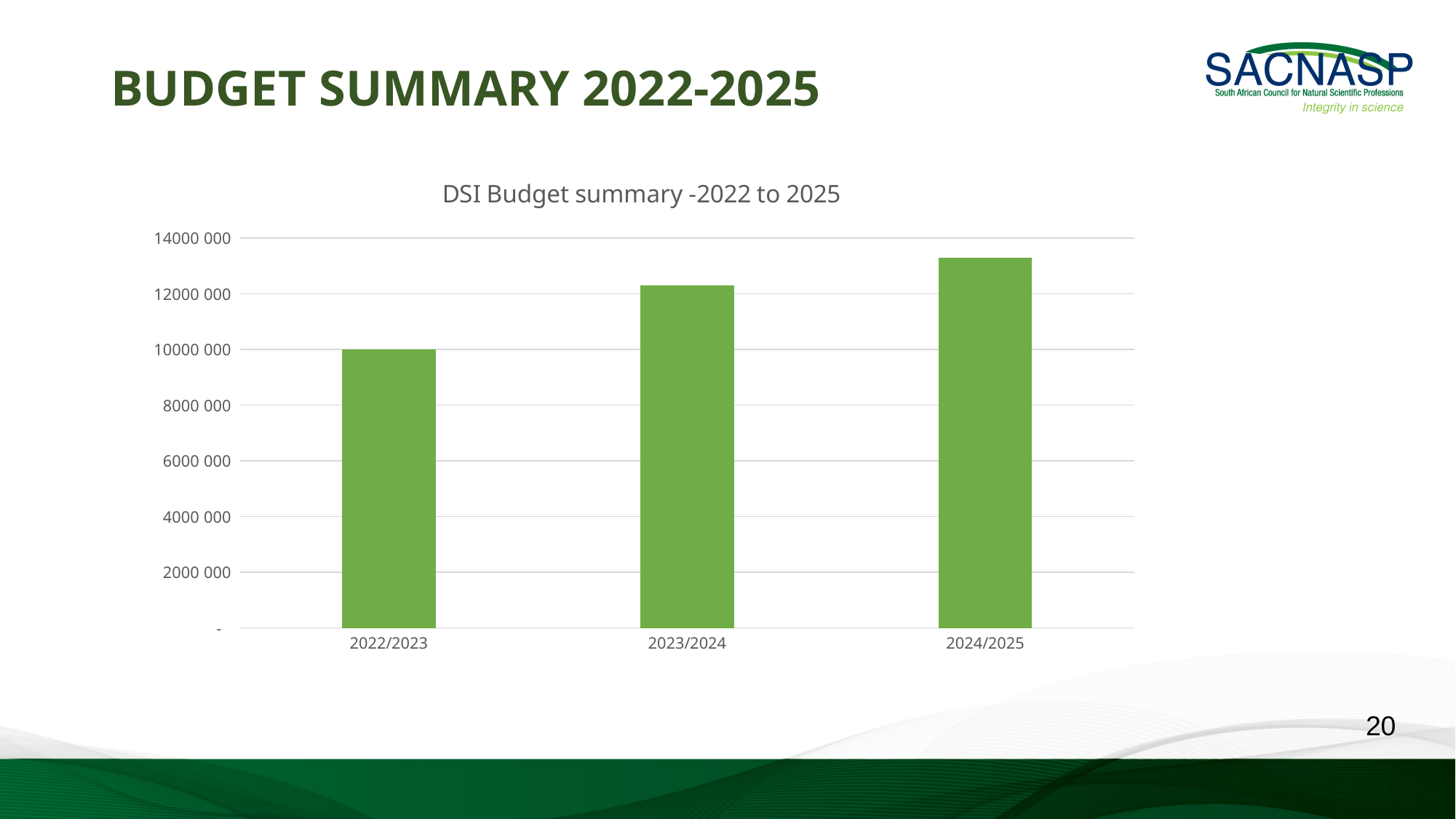
How many financial years are plotted in the chart? 3 Which financial year has the highest budget in the chart? 2024/2025 Is the value for 2024/2025 greater or less than 14000 000? less What colour are the bars in the chart? green Is the value for 2024/2025 greater or less than 12000 000? greater What kind of chart is shown on the slide? bar chart What is the budget value for 2022/2023? 10000 000 What is the title of the chart? DSI Budget summary -2022 to 2025 Which is larger, the budget for 2023/2024 or for 2024/2025? 2024/2025 Which financial year has the lowest budget in the chart? 2022/2023 Do the budget values rise or fall from 2022/2023 to 2024/2025? rise Is the value for 2023/2024 greater or less than 12000 000? greater